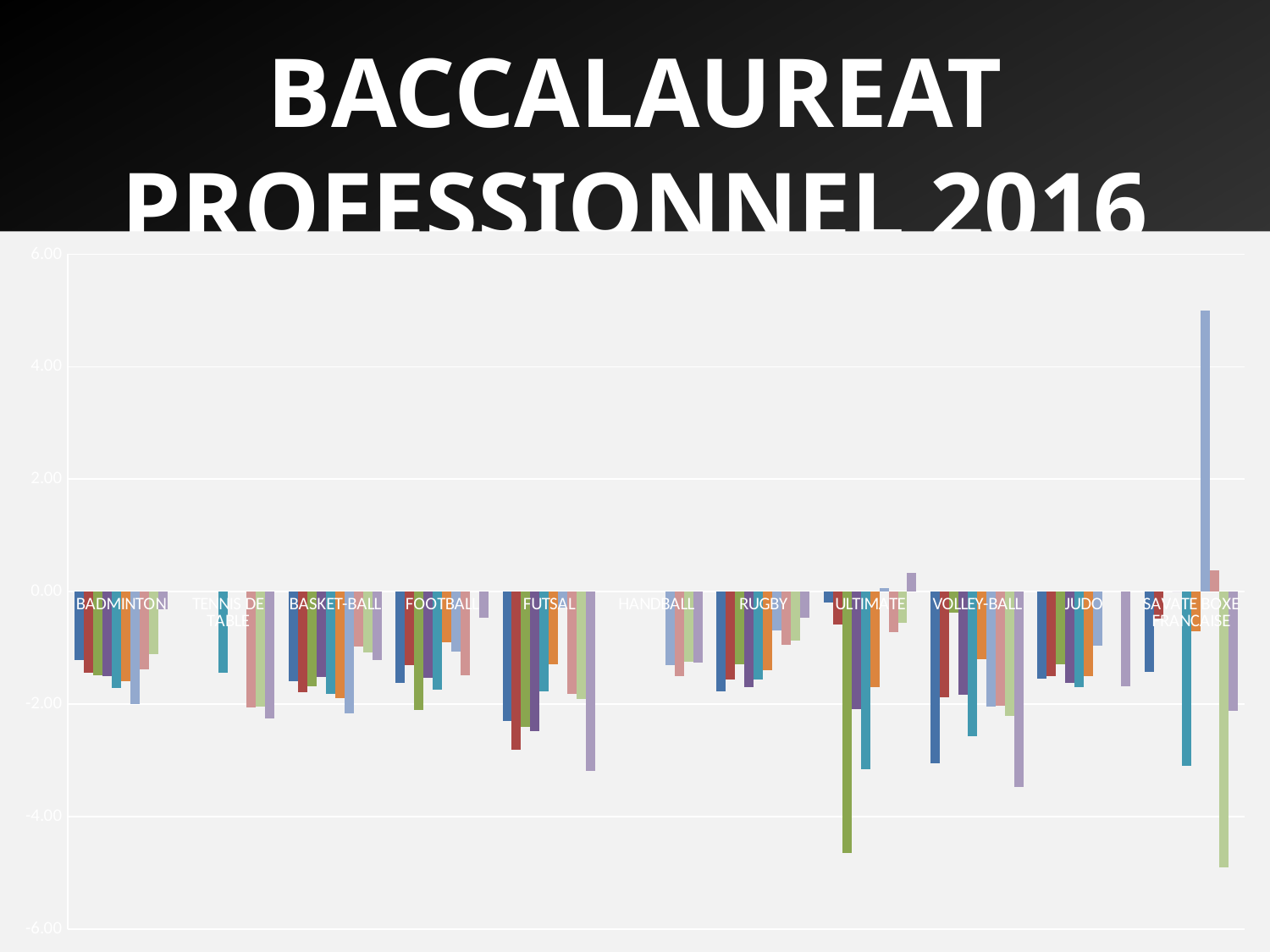
What is the highest value shown on the vertical axis of the chart? 6.00 What kind of chart is shown on the slide? bar chart Which category contains the bar that rises highest above zero? SAVATE BOXE FRANCAISE Is the lowest bar in VOLLEY-BALL greater or less than -2.00? less What is the title shown above the chart? BACCALAUREAT PROFESSIONNEL 2016 Is the lowest bar in FUTSAL greater or less than -2.00? less Is the lowest bar in HANDBALL greater or less than -2.00? greater How many sport categories are shown on the x axis of the chart? 11 Which has the lower minimum bar, FUTSAL or HANDBALL? FUTSAL